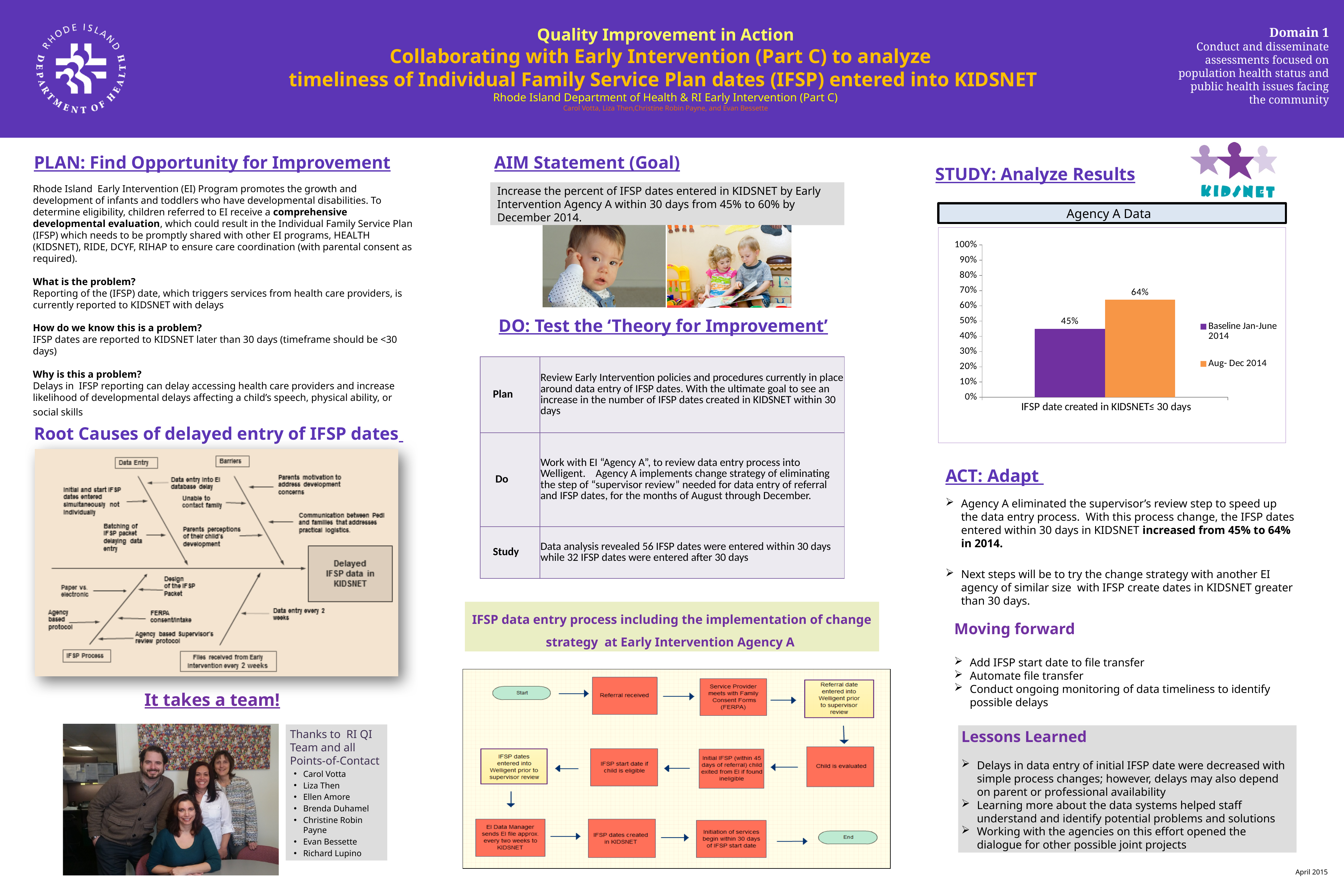
What is the x-axis category label in the 'Agency A Data' chart? IFSP date created in KIDSNET≤ 30 days In the 'Agency A Data' chart, what is the value for Baseline Jan-June 2014? 45% In the 'Agency A Data' chart, what is the value for Aug- Dec 2014? 64% In the 'Agency A Data' chart, which series has the higher value? Aug- Dec 2014 How many series does the legend of the 'Agency A Data' chart list? 2 In the 'Agency A Data' chart, is the Baseline Jan-June 2014 value larger or smaller than the Aug- Dec 2014 value? smaller In the 'Agency A Data' chart, is the value for Aug- Dec 2014 greater or less than 50%? greater In the 'Agency A Data' chart, which series has the lower value? Baseline Jan-June 2014 In the 'Agency A Data' chart, is the value for Baseline Jan-June 2014 greater or less than 50%? less How many categories are shown on the x axis of the 'Agency A Data' chart? 1 In the 'Agency A Data' chart, what is the difference between the Aug- Dec 2014 value and the Baseline Jan-June 2014 value? 19% What kind of chart is shown under 'Agency A Data'? bar chart